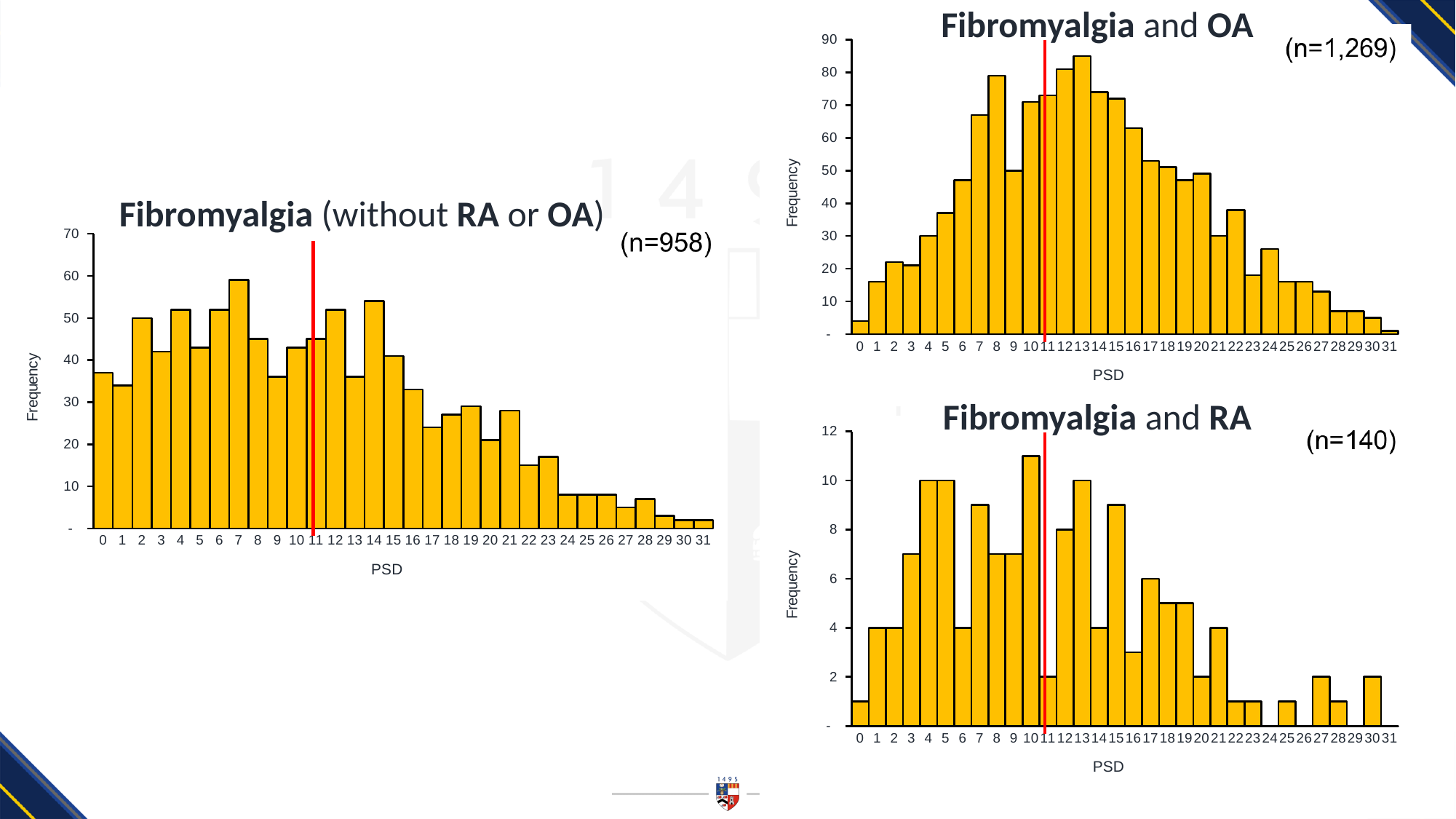
In the 'Fibromyalgia (without RA or OA)' chart, which PSD value has the highest frequency? 7 In the 'Fibromyalgia (without RA or OA)' chart, is the frequency at PSD 0 greater or less than 40? less How many PSD categories are shown on the x axis of the 'Fibromyalgia and OA' chart? 32 In the 'Fibromyalgia and RA' chart, what is the frequency at PSD 4? 10 In the 'Fibromyalgia and RA' chart, what is the difference between the frequency at PSD 4 and the frequency at PSD 12? 2 In the 'Fibromyalgia and OA' chart, is the frequency at PSD 8 greater or less than 70? greater In the 'Fibromyalgia and OA' chart, which has the higher frequency, PSD 16 or PSD 20? PSD 16 In the 'Fibromyalgia and RA' chart, what is the frequency at PSD 12? 8 In the 'Fibromyalgia and RA' chart, which PSD value has the highest frequency? 10 In the 'Fibromyalgia and RA' chart, what is the frequency at PSD 17? 6 In the 'Fibromyalgia and OA' chart, which PSD value has the highest frequency? 13 What kind of chart is the 'Fibromyalgia (without RA or OA)' chart? bar chart